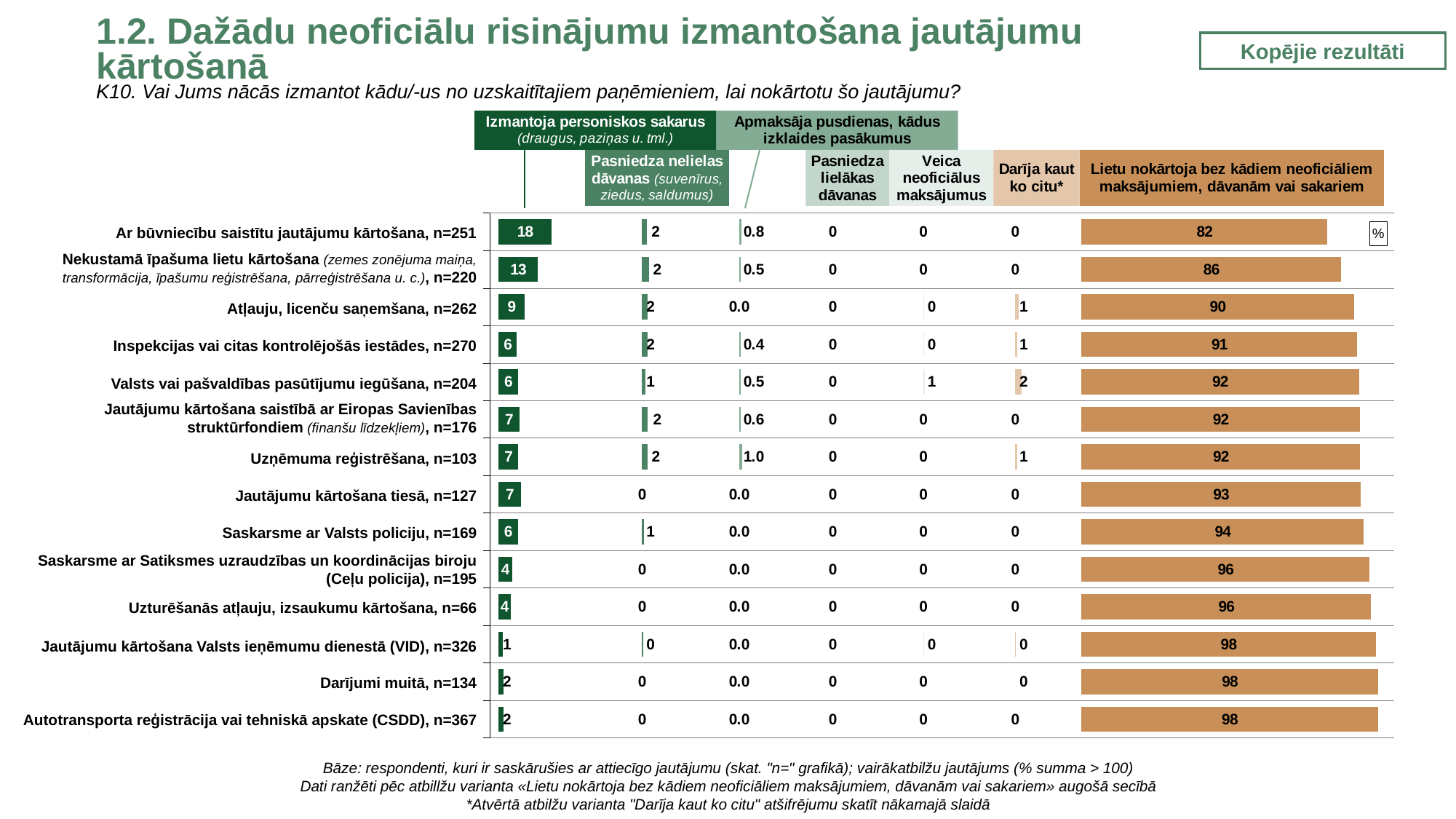
What kind of chart is shown on the slide? Bar chart How many rows (categories) are shown in the chart? 14 Do the values for "Lietu nokārtoja bez kādiem neoficiāliem maksājumiem, dāvanām vai sakariem" rise or fall going from the top row to the bottom row? Rise What is the value for "Lietu nokārtoja bez kādiem neoficiāliem maksājumiem, dāvanām vai sakariem" in the row "Darījumi muitā, n=134"? 98 Which row has the highest value for "Izmantoja personiskos sakarus"? Ar būvniecību saistītu jautājumu kārtošana, n=251 Which row has the lowest value for "Lietu nokārtoja bez kādiem neoficiāliem maksājumiem, dāvanām vai sakariem"? Ar būvniecību saistītu jautājumu kārtošana, n=251 For "Izmantoja personiskos sakarus", which is larger: "Atļauju, licenču saņemšana, n=262" or "Inspekcijas vai citas kontrolējošās iestādes, n=270"? Atļauju, licenču saņemšana, n=262 What is the difference between the "Lietu nokārtoja bez kādiem neoficiāliem maksājumiem, dāvanām vai sakariem" values for "Nekustamā īpašuma lietu kārtošana, n=220" and "Ar būvniecību saistītu jautājumu kārtošana, n=251"? 4 How many series (answer options) does the chart show? 7 What is the value for "Apmaksāja pusdienas, kādus izklaides pasākumus" in the row "Uzņēmuma reģistrēšana, n=103"? 1.0 What is the value for "Izmantoja personiskos sakarus" in the row "Ar būvniecību saistītu jautājumu kārtošana, n=251"? 18 What is the value for "Darīja kaut ko citu*" in the row "Valsts vai pašvaldības pasūtījumu iegūšana, n=204"? 2